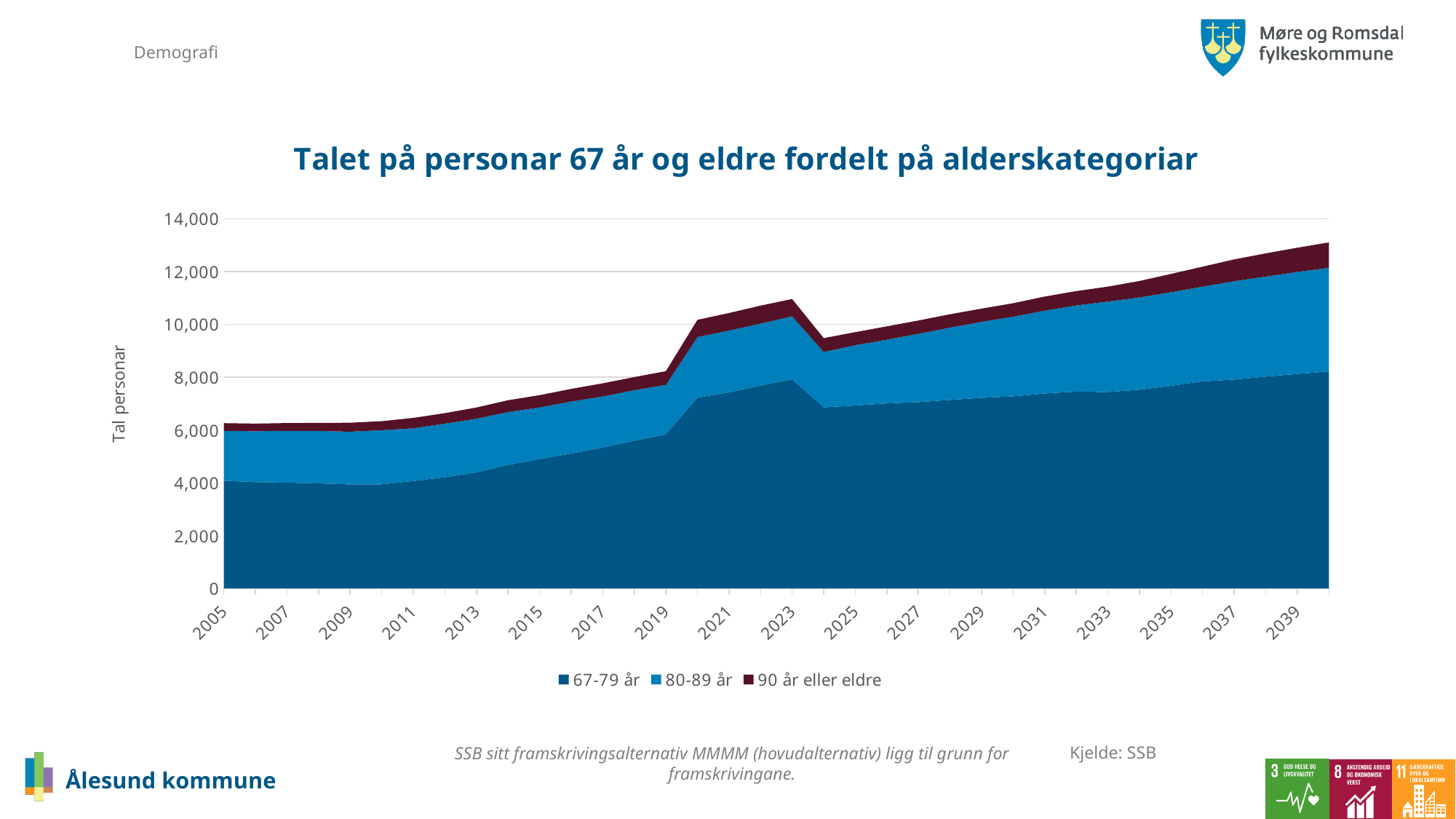
Which age category has the smallest number of persons throughout the chart? 90 år eller eldre How many series does the legend list? 3 Is the value for 67-79 år in 2013 greater or less than 4,000? greater Which age category has the largest number of persons throughout the chart? 67-79 år Is the total number of persons 67 years and older in 2023 greater or less than 10,000? greater What kind of chart is shown on the slide? Stacked area chart What is the label on the vertical axis? Tal personar What is the title of the chart? Talet på personar 67 år og eldre fordelt på alderskategoriar Does the total number of persons 67 years and older rise or fall from 2005 to 2040? Rise Is the total number of persons 67 years and older in 2015 greater or less than 8,000? less In 2040, which is larger: the number of persons aged 67-79 år or the number aged 90 år eller eldre? 67-79 år